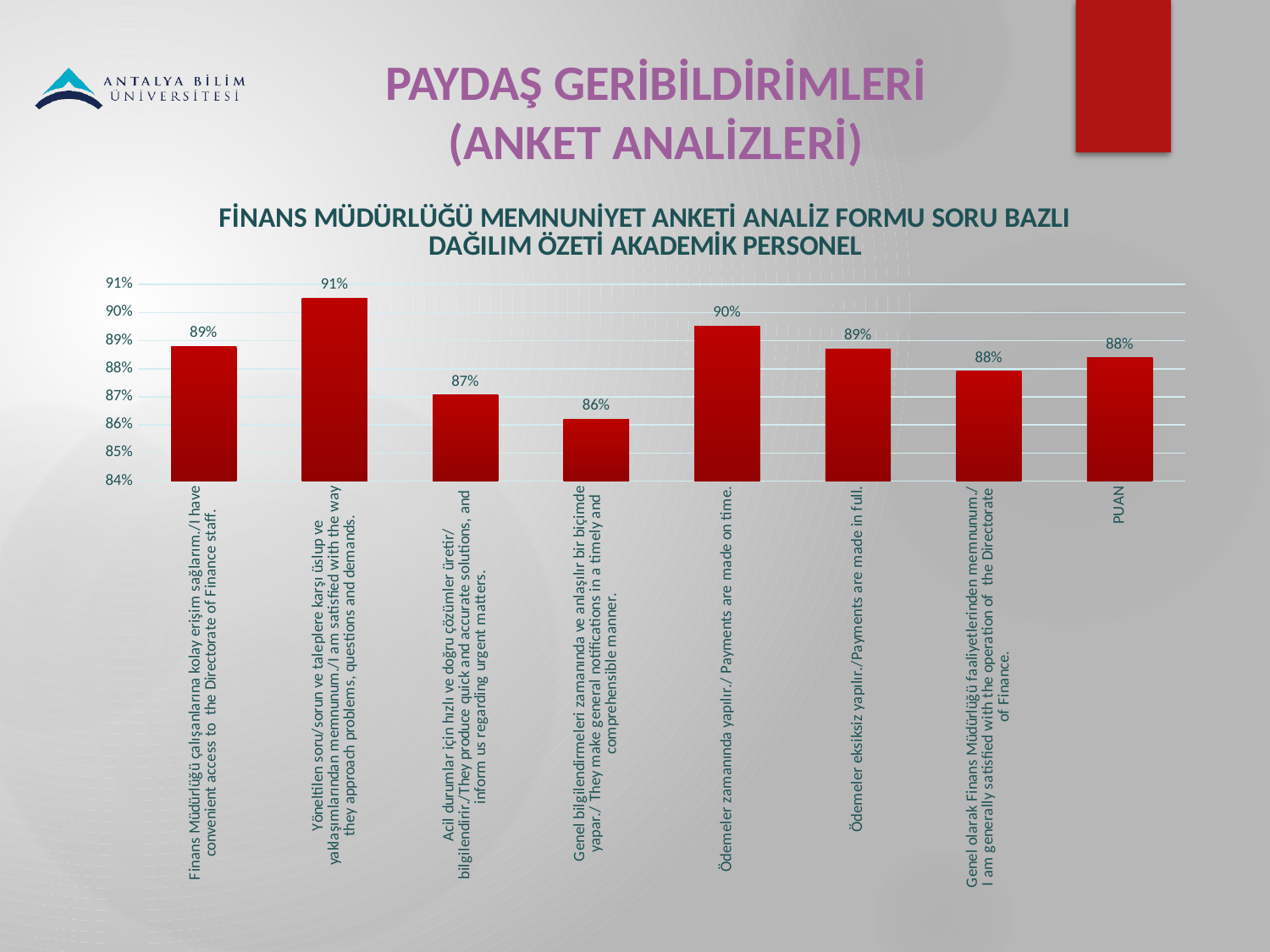
What is the difference between "They produce quick and accurate solutions, and inform us regarding urgent matters" (87%) and "I am generally satisfied with the operation of the Directorate of Finance" (88%)? 1% What is the value for "Payments are made on time"? 90% What is the value for "I have convenient access to the Directorate of Finance staff"? 89% What is the title of the chart? FİNANS MÜDÜRLÜĞÜ MEMNUNİYET ANKETİ ANALİZ FORMU SORU BAZLI DAĞILIM ÖZETİ AKADEMİK PERSONEL What is the difference between the highest value (91%) and the lowest value (86%)? 5% What is the value for "PUAN"? 88% How many bars are plotted in the chart? 8 What type of chart is shown on the slide? Bar chart What is the value for "They make general notifications in a timely and comprehensible manner"? 86% Which category has the highest value? I am satisfied with the way they approach problems, questions and demands (91%) Which is larger: the value for "Payments are made on time" or the value for "Payments are made in full"? Payments are made on time Which category has the lowest value? They make general notifications in a timely and comprehensible manner (86%)